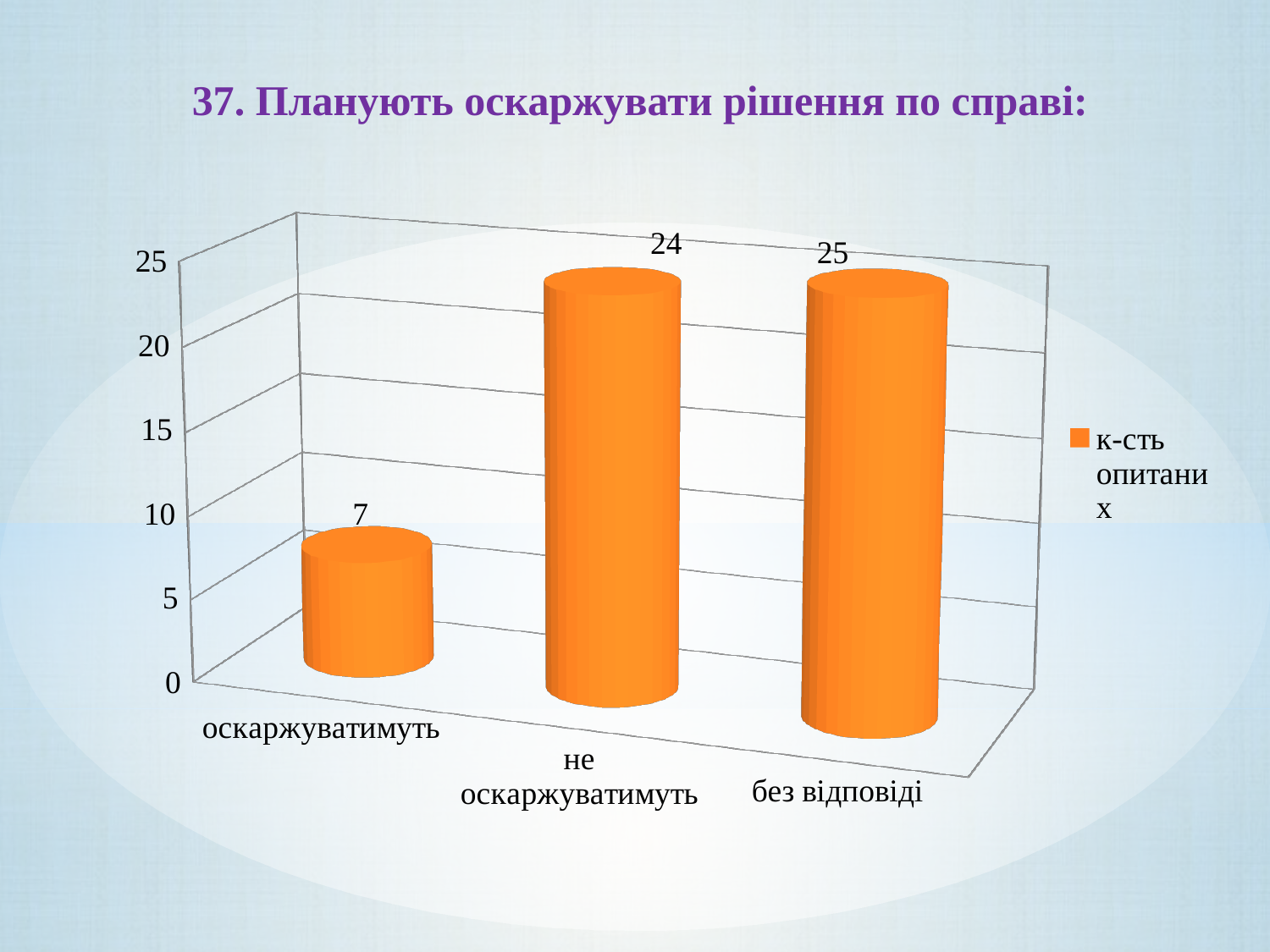
Which category has the lowest value? оскаржуватимуть How many categories are shown on the x axis? 3 Is the value for "оскаржуватимуть" greater or less than 10? less What is the legend entry for the series? к-сть опитаних What is the value for "без відповіді"? 25 What is the value for "оскаржуватимуть"? 7 What is the difference between the values for "не оскаржуватимуть" and "оскаржуватимуть"? 17 What kind of chart is shown on the slide? bar chart What is the difference between the values for "без відповіді" and "оскаржуватимуть"? 18 Which is larger: the value for "оскаржуватимуть" or the value for "не оскаржуватимуть"? не оскаржуватимуть What is the value for "не оскаржуватимуть"? 24 How many series does the legend list? 1